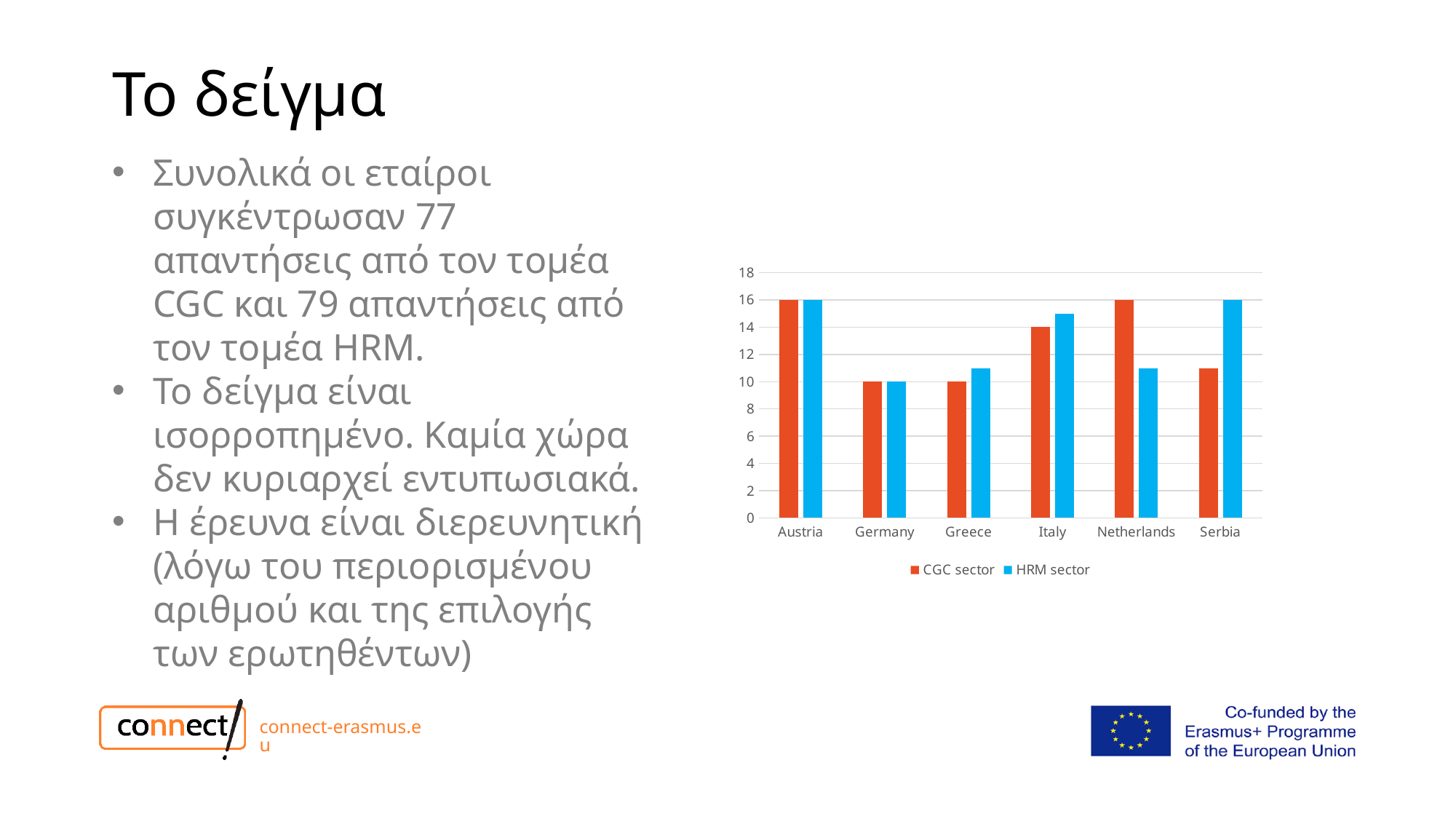
How many series does the chart's legend list? 2 What is the value for Italy in the CGC sector series? 14 What is the difference between the CGC sector values for Netherlands and Germany? 6 What is the value for Serbia in the HRM sector series? 16 For Netherlands, which series has the larger value, CGC sector or HRM sector? CGC sector What is the value for Germany in the HRM sector series? 10 How many countries are shown on the x axis of the chart? 6 Is the HRM sector value for Netherlands greater or less than 14? less Which country has the lowest value in the HRM sector series? Germany Is the HRM sector value for Italy greater or less than 12? greater What is the value for Austria in the CGC sector series? 16 For Serbia, which series has the larger value, CGC sector or HRM sector? HRM sector